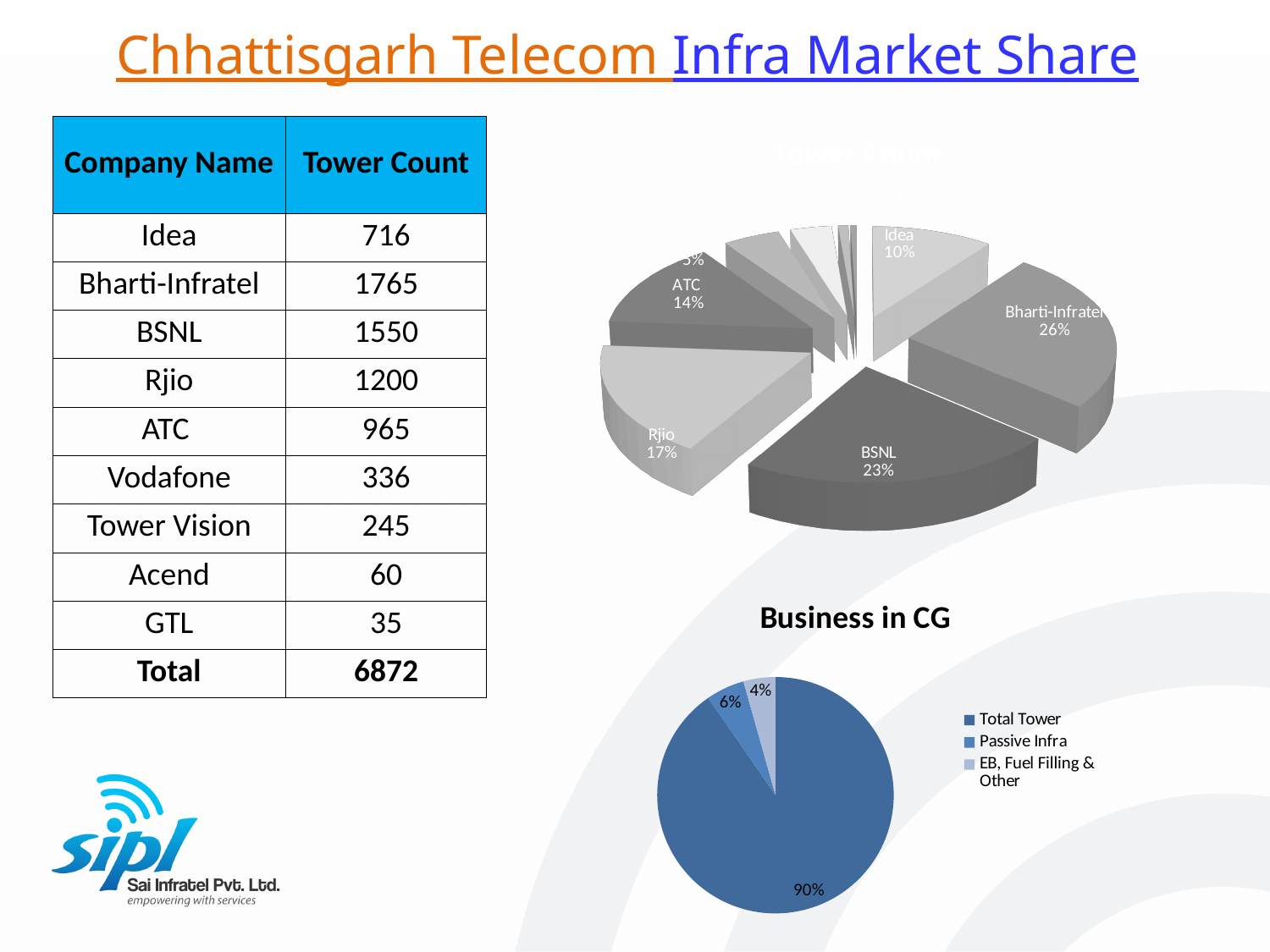
In the 'Business in CG' pie chart, what share is shown for Passive Infra? 6% In the 'Business in CG' pie chart, which category has the smallest slice? EB, Fuel Filling & Other In the 3D pie chart at the top right of the slide, what percentage is shown for ATC? 14% In the 'Business in CG' pie chart, what is the difference between the Passive Infra share and the EB, Fuel Filling & Other share? 2% In the 3D pie chart at the top right of the slide, what percentage is shown for Bharti-Infratel? 26% In the 3D pie chart at the top right of the slide, which labeled company has the largest slice? Bharti-Infratel In the 3D pie chart at the top right of the slide, what percentage is shown for BSNL? 23% In the 3D pie chart at the top right of the slide, which has the larger share, Rjio or ATC? Rjio In the 'Business in CG' pie chart, what share is shown for Total Tower? 90% What kind of chart is 'Business in CG'? Pie chart How many entries does the legend of the 'Business in CG' chart list? 3 In the 3D pie chart at the top right of the slide, what is the difference between the Bharti-Infratel share and the BSNL share? 3%